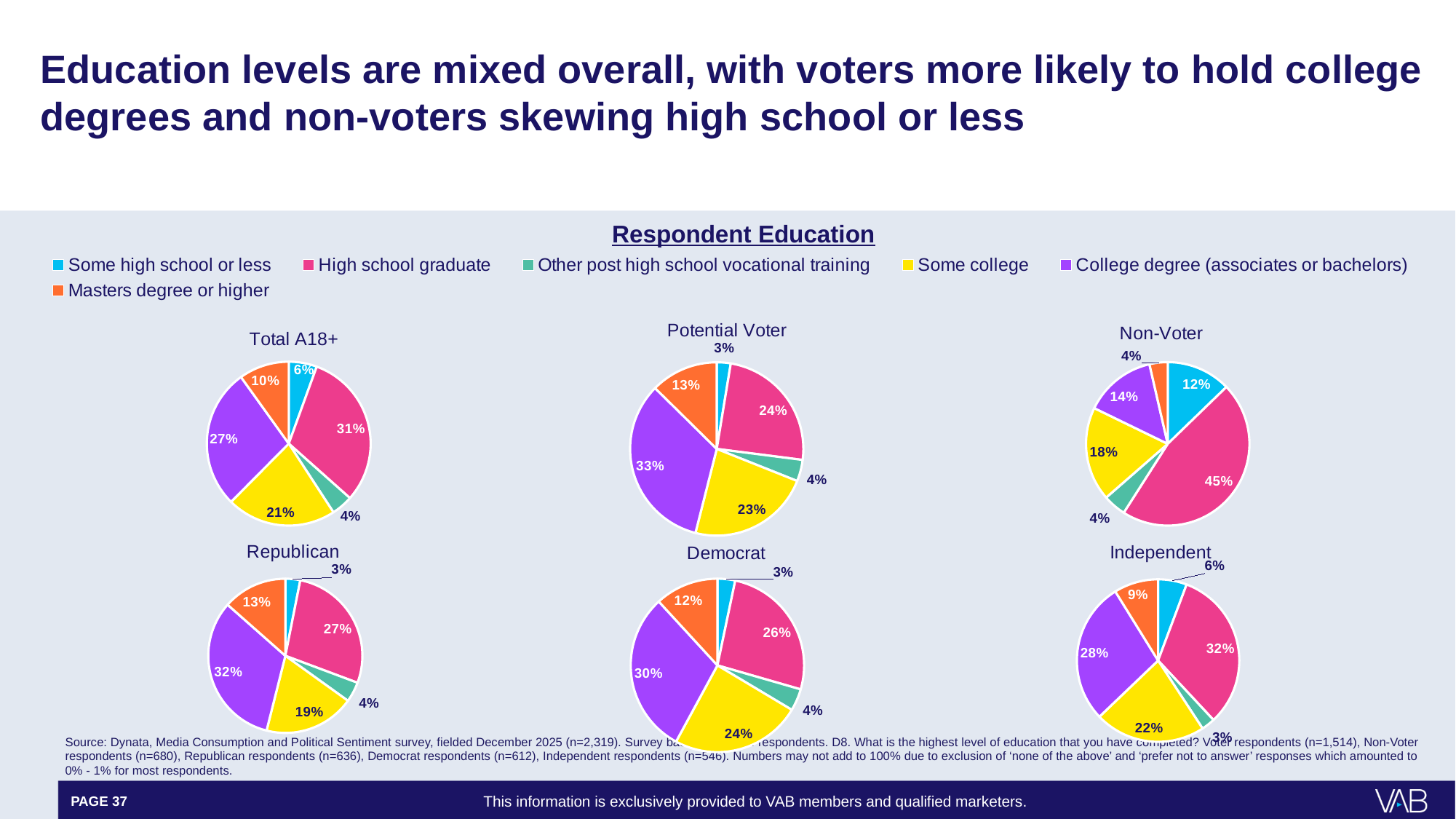
In the Republican pie chart, what percentage have a masters degree or higher? 13% Which is larger: the college degree share in the Republican chart or in the Democrat chart? Republican (32%) How many education categories does the legend list? 6 In the Potential Voter pie chart, what share holds a college degree (associates or bachelors)? 33% In the Non-Voter pie chart, which education level has the smallest share? Other post high school vocational training and Masters degree or higher (both 4%) What is the difference between the high school graduate share in the Non-Voter chart and in the Potential Voter chart? 21 percentage points In the Independent pie chart, which education level has the largest share? High school graduate In the Democrat pie chart, what percentage have some college? 24% In the Total A18+ pie chart, what percentage have some high school or less? 6% What type of chart is used to show Respondent Education? Pie chart How many pie charts are shown on the slide? 6 In the Non-Voter pie chart, what percentage of respondents are high school graduates? 45%